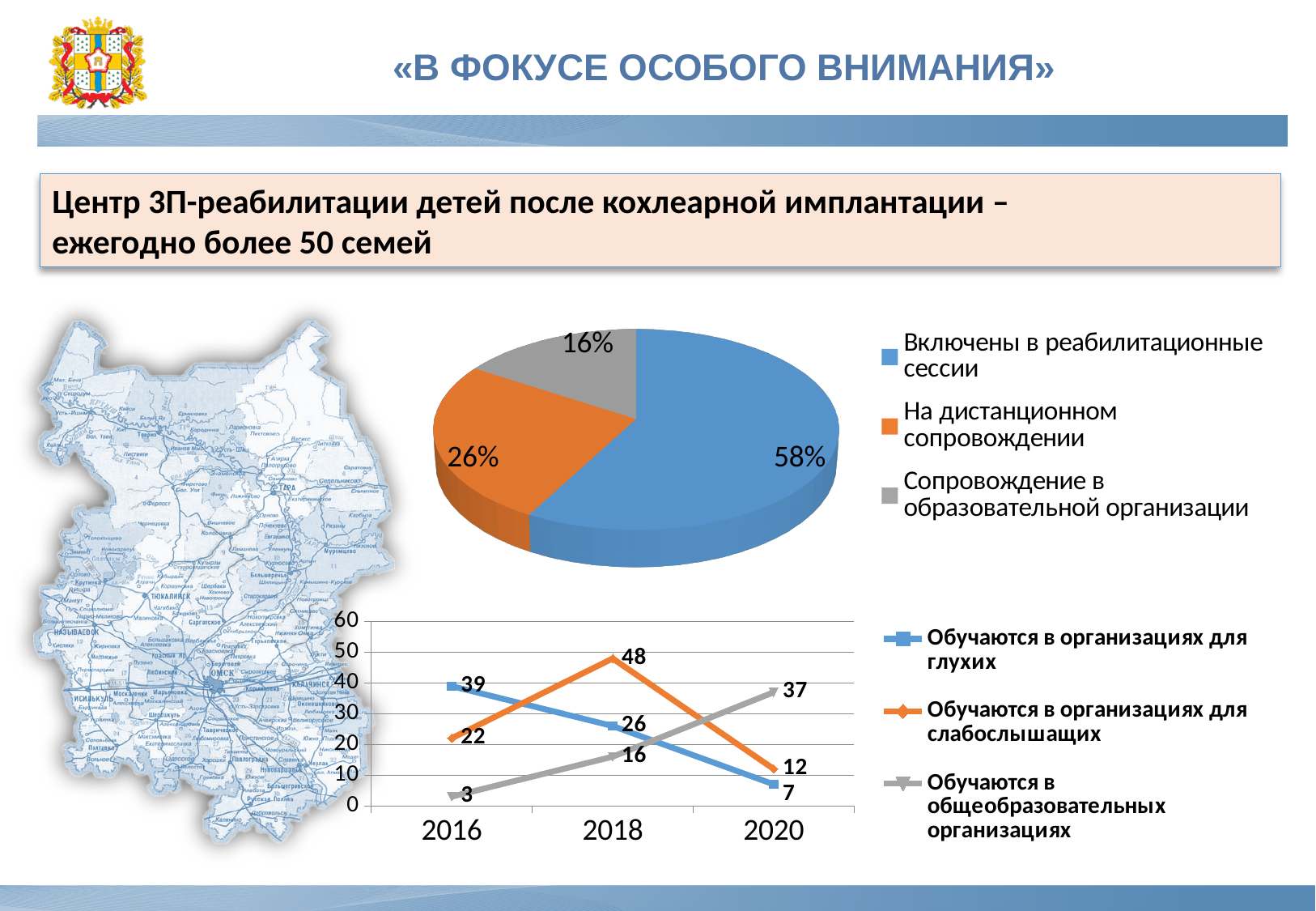
In the line chart, what is the value for 'Обучаются в общеобразовательных организациях' in 2016? 3 In the line chart, what is the difference between the 2016 and 2020 values for 'Обучаются в организациях для глухих'? 32 In the pie chart, what share is labelled for 'На дистанционном сопровождении'? 26% In the pie chart, which category has the smallest slice? Сопровождение в образовательной организации In the pie chart, what share is labelled for 'Включены в реабилитационные сессии'? 58% In the line chart, does the value for 'Обучаются в общеобразовательных организациях' rise or fall from 2016 to 2020? Rise How many slices does the pie chart have? 3 What kind of chart is the top chart on the slide? Pie chart In the line chart, what is the value for 'Обучаются в организациях для слабослышащих' in 2018? 48 In the line chart, what is the value for 'Обучаются в организациях для глухих' in 2020? 7 In the line chart, which series has the highest value in 2020? Обучаются в общеобразовательных организациях How many series does the legend of the line chart list? 3